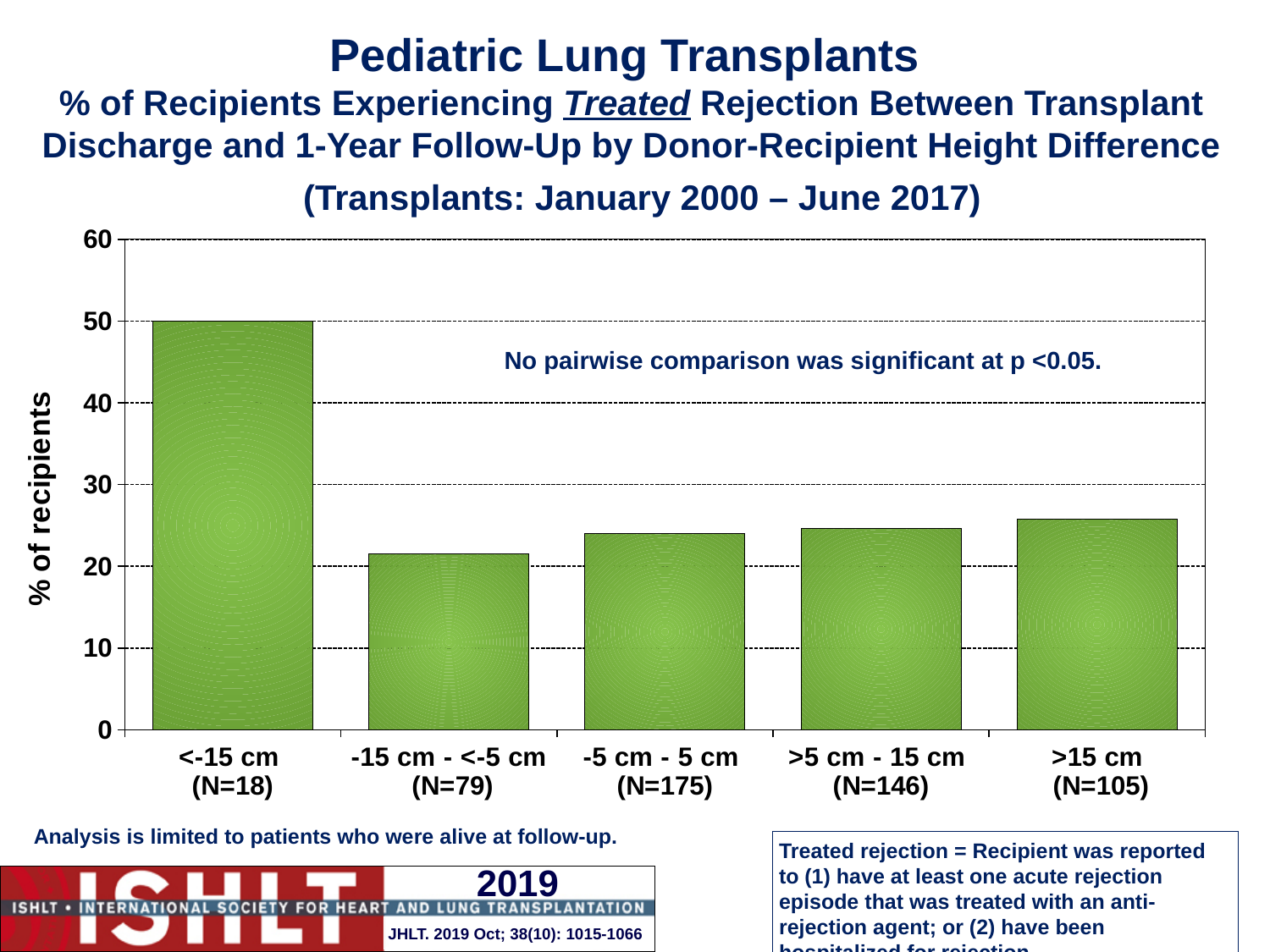
What is the label of the y axis? % of recipients What kind of chart is shown on the slide? bar chart Is the value for <-15 cm greater or less than 40? greater How many transplants (N) are in the >15 cm category? 105 Which is larger, the value for -15 cm - <-5 cm or the value for >15 cm? >15 cm Which height difference category has the highest % of recipients experiencing treated rejection? <-15 cm (N=18) Is the value for -5 cm - 5 cm greater or less than 30? less Is the value for >15 cm greater or less than 20? greater How many donor-recipient height difference categories are shown on the x axis? 5 Which height difference category has the lowest % of recipients experiencing treated rejection? -15 cm - <-5 cm (N=79) Which is larger, the value for <-15 cm or the value for >15 cm? <-15 cm